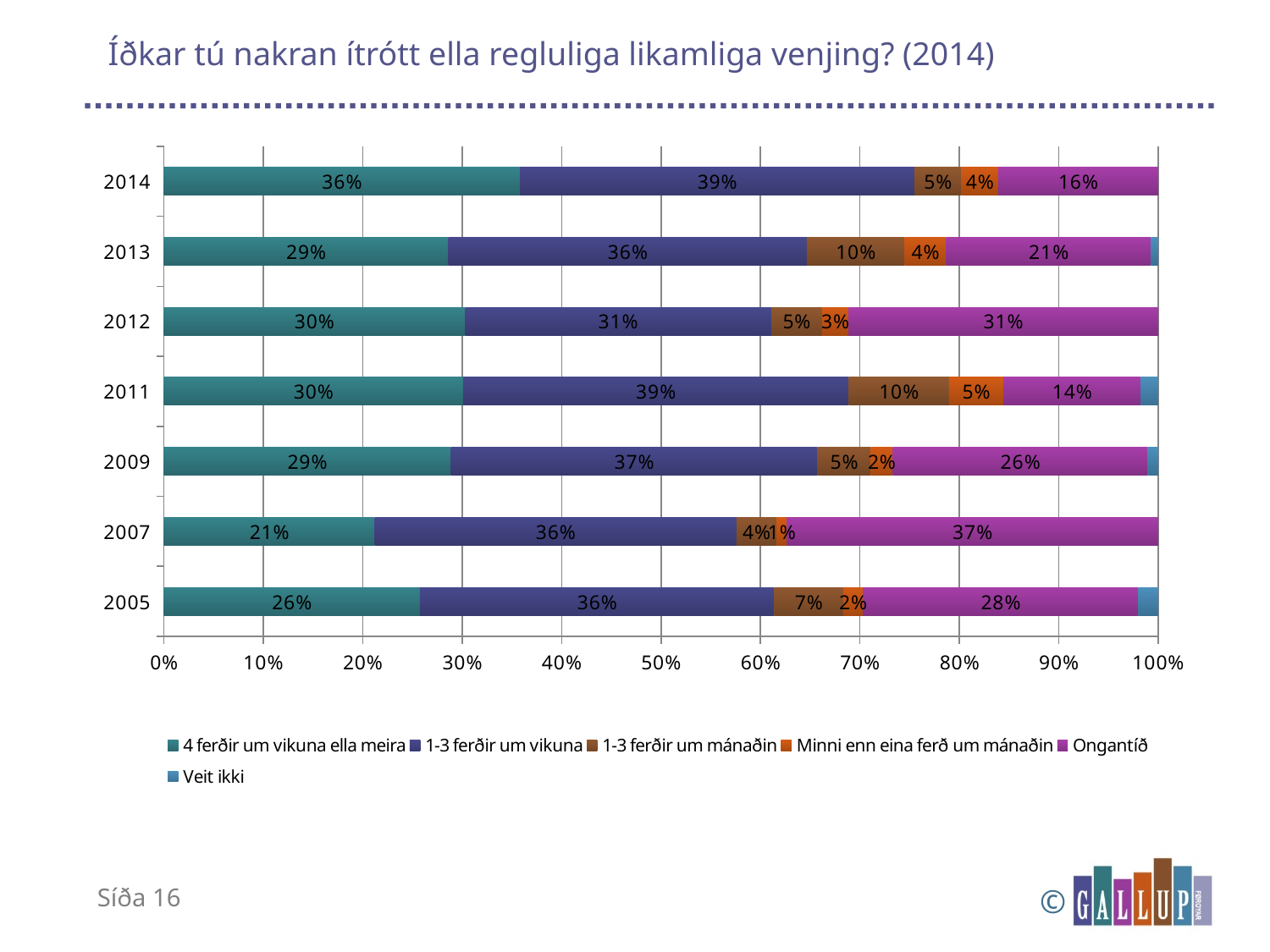
In which year is the value for '4 ferðir um vikuna ella meira' highest? 2014 What is the value for '1-3 ferðir um mánaðin' in 2011? 10% In which year is the value for 'Ongantíð' lowest? 2011 What is the value for '1-3 ferðir um vikuna' in 2012? 31% What kind of chart is shown on the slide? Stacked bar chart What is the difference between the '4 ferðir um vikuna ella meira' values for 2014 and 2013? 7 percentage points Which year has the larger 'Ongantíð' value, 2012 or 2014? 2012 What is the value for '4 ferðir um vikuna ella meira' in 2014? 36% What is the value for 'Ongantíð' in 2007? 37% What is the title of the chart? Íðkar tú nakran ítrótt ella regluliga likamliga venjing? (2014) How many years are shown on the vertical axis of the chart? 7 How many series does the legend list? 6